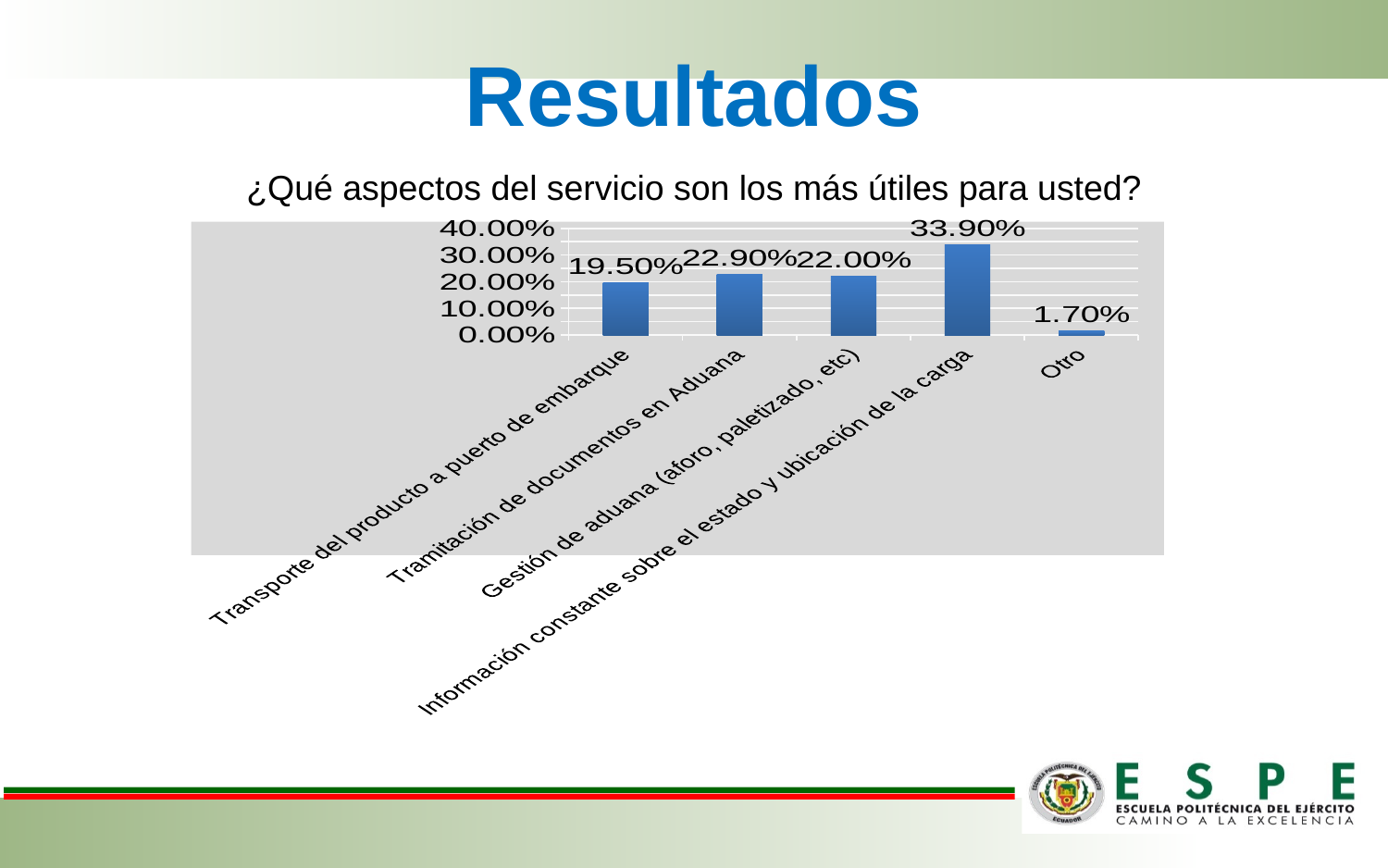
What is the value for "Otro"? 1.70% What is the value for "Información constante sobre el estado y ubicación de la carga"? 33.90% What is the difference between the values for "Información constante sobre el estado y ubicación de la carga" and "Otro"? 32.20% What is the value for "Tramitación de documentos en Aduana"? 22.90% What kind of chart is shown on the slide? Bar chart What is the value for "Transporte del producto a puerto de embarque"? 19.50% What question does the chart answer, as written above it? ¿Qué aspectos del servicio son los más útiles para usted? How many categories are shown in the chart? 5 Which category has the highest value? Información constante sobre el estado y ubicación de la carga Which is larger: the value for "Tramitación de documentos en Aduana" or the value for "Transporte del producto a puerto de embarque"? Tramitación de documentos en Aduana What is the value for "Gestión de aduana (aforo, paletizado, etc)"? 22.00% Which category has the lowest value? Otro